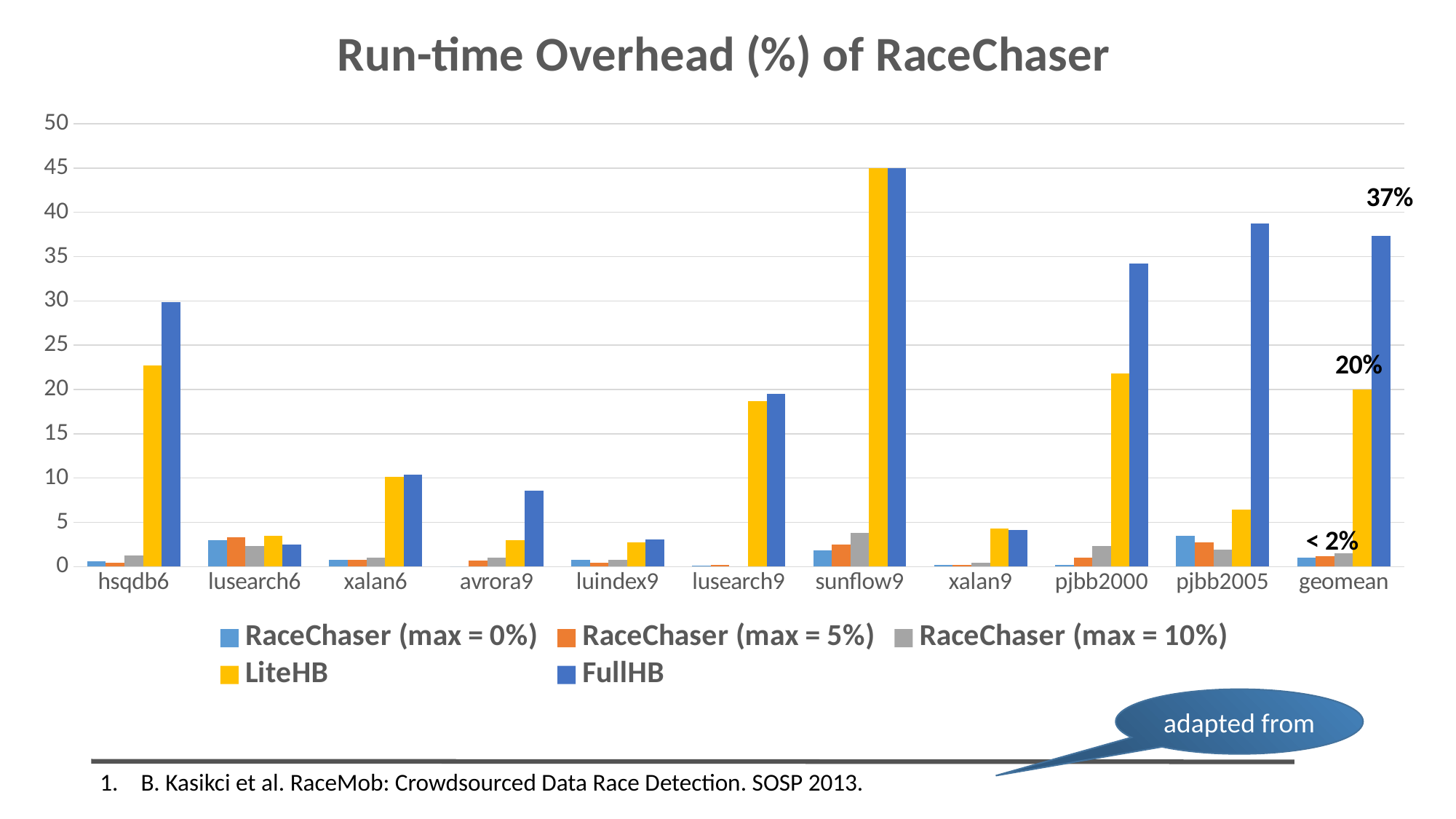
How many benchmark categories are shown along the x axis? 11 What kind of chart is shown on the slide? bar chart What is the labelled FullHB overhead for geomean? 37% What is the labelled LiteHB overhead for geomean? 20% Is the LiteHB value for pjbb2005 greater or less than 10? less What is the title of the chart? Run-time Overhead (%) of RaceChaser Is the FullHB value for avrora9 greater or less than 10? less Is the LiteHB value for sunflow9 greater or less than 40? greater Which benchmark has the highest FullHB bar? sunflow9 Which has the larger FullHB value, pjbb2000 or pjbb2005? pjbb2005 How many series does the legend list? 5